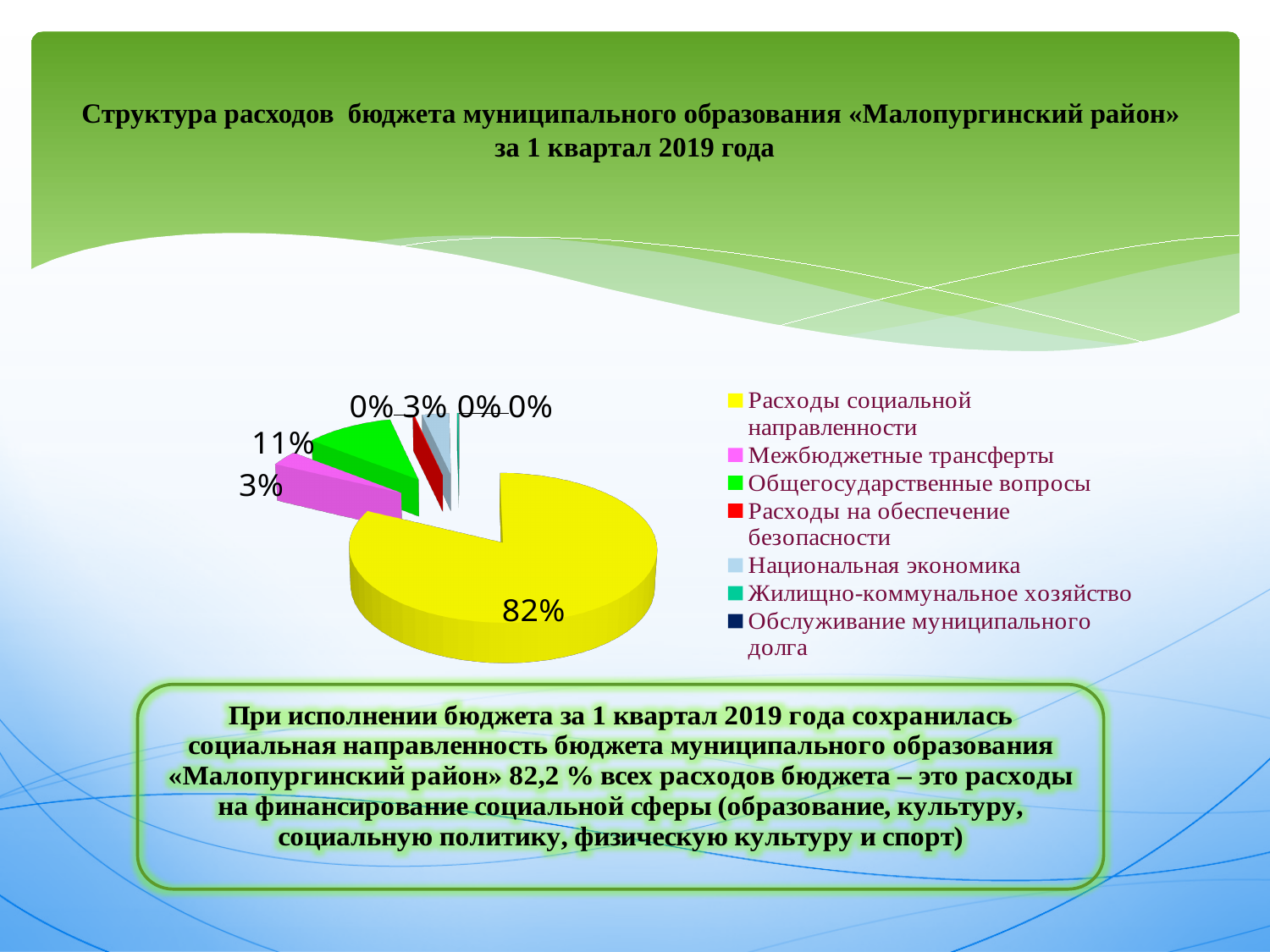
What kind of chart is shown on the slide? Pie chart What colour is the slice for «Расходы социальной направленности»? Yellow What is the title of the chart on the slide? Структура расходов бюджета муниципального образования «Малопургинский район» за 1 квартал 2019 года Which is larger: «Общегосударственные вопросы» or «Межбюджетные трансферты»? Общегосударственные вопросы What is the difference in percentage points between «Общегосударственные вопросы» and «Межбюджетные трансферты»? 8 percentage points What is the difference in percentage points between «Расходы социальной направленности» and «Общегосударственные вопросы»? 71 percentage points What is the value shown for «Межбюджетные трансферты»? 3% Which is larger: «Расходы социальной направленности» or «Общегосударственные вопросы»? Расходы социальной направленности What is the value shown for «Общегосударственные вопросы»? 11% What share of the pie does «Расходы социальной направленности» take? 82% How many categories does the legend list? 7 Which category has the largest share of the pie? Расходы социальной направленности